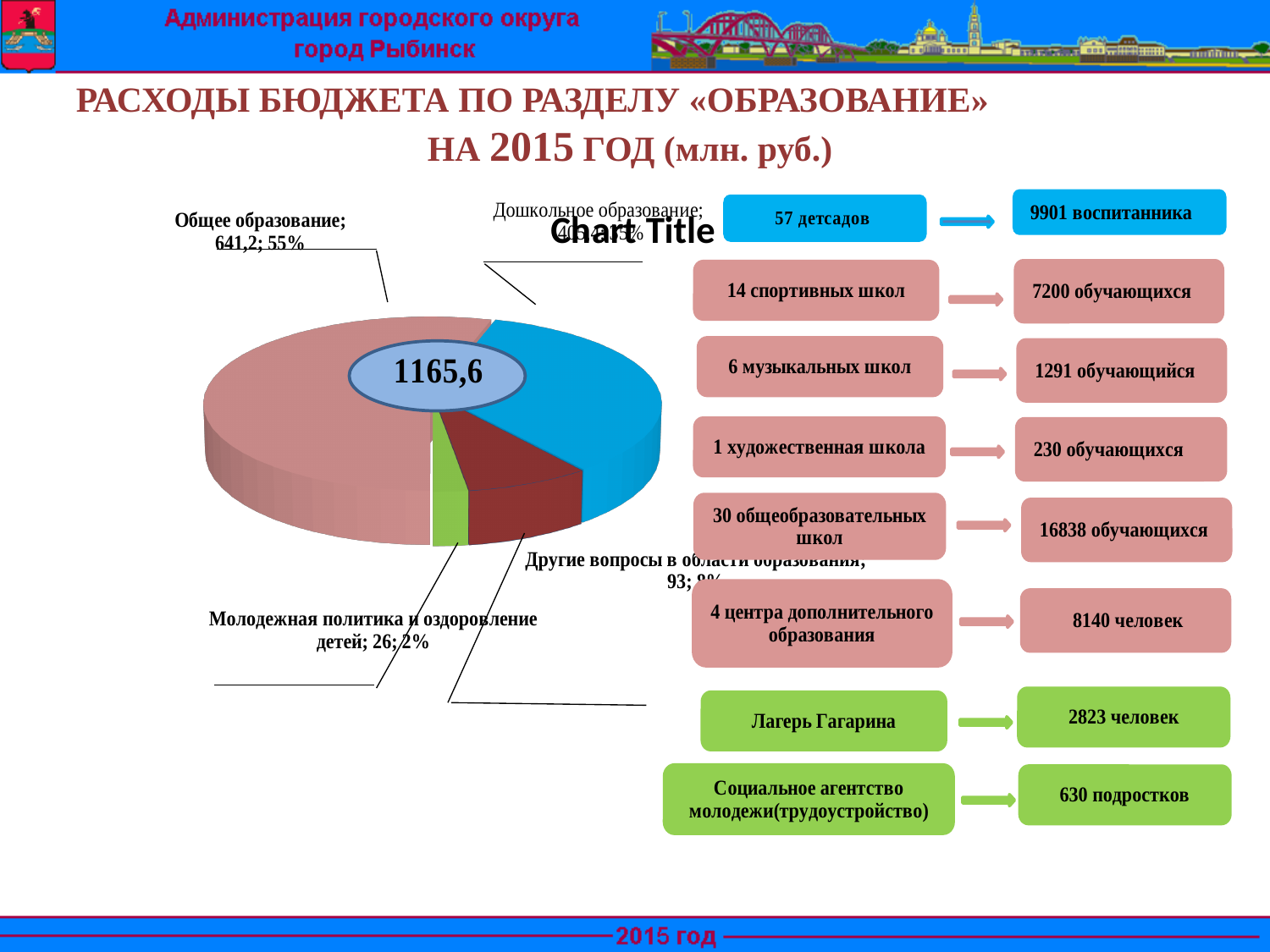
What value is shown for 'Молодежная политика и оздоровление детей' in the pie chart? 26 Which category has the largest slice in the pie chart? Общее образование What value is shown for the 'Общее образование' slice of the pie chart? 641,2 What is the difference between the values for 'Общее образование' and 'Молодежная политика и оздоровление детей'? 615,2 Which slice is larger: 'Общее образование' or 'Дошкольное образование'? Общее образование What type of chart is shown on the slide? Pie chart What value is shown for 'Другие вопросы в области образования' in the pie chart? 93 What share of the pie does 'Общее образование' account for? 55% What share of the pie does 'Молодежная политика и оздоровление детей' represent? 2% How many categories are shown in the pie chart? 4 Which category has the smallest slice in the pie chart? Молодежная политика и оздоровление детей What number is displayed in the oval at the centre of the pie chart? 1165,6